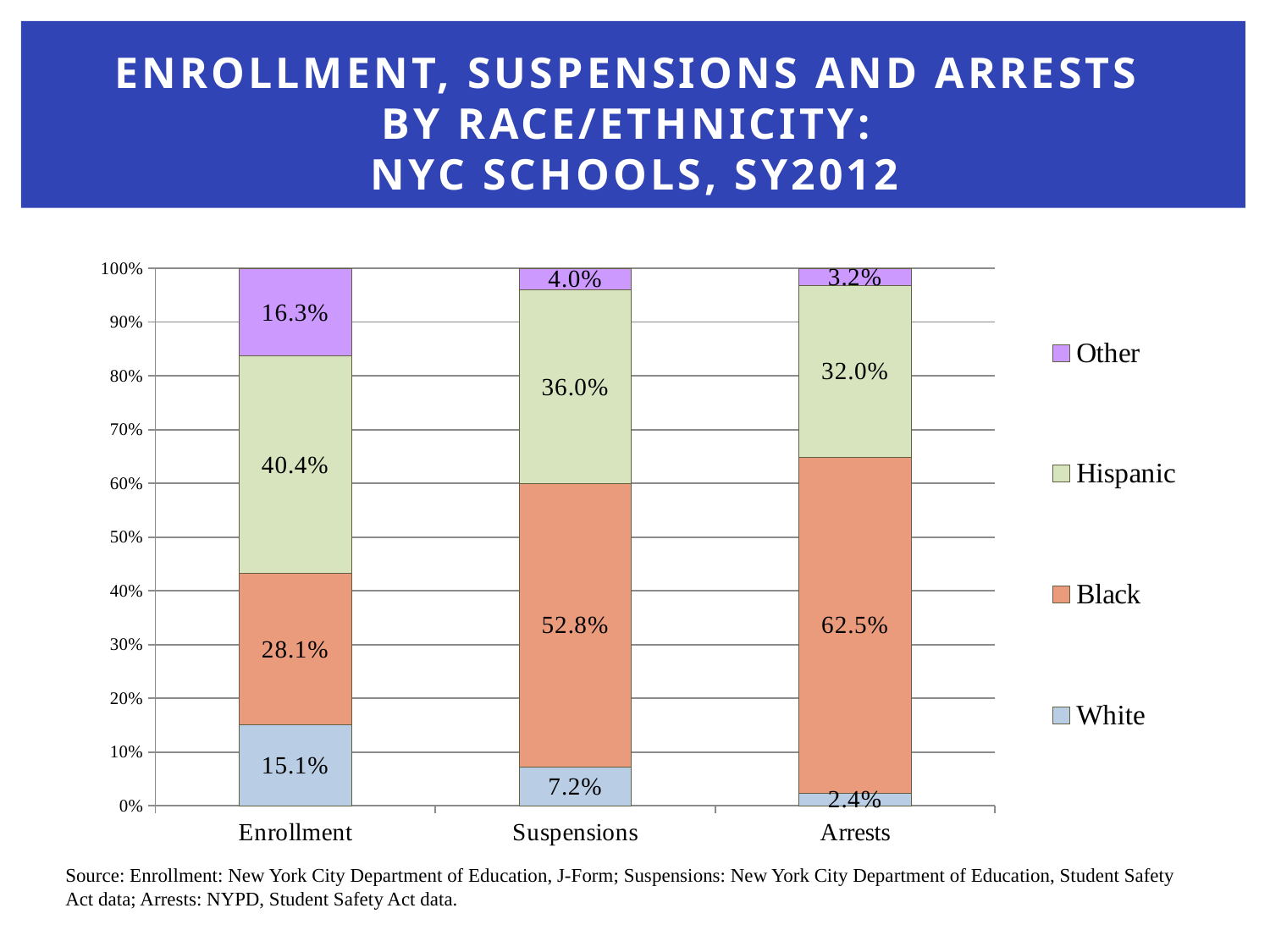
How many categories are shown on the x axis? 3 Which category has the lowest White share? Arrests What is the Hispanic share of Suspensions? 36.0% Which category has the highest Black share? Arrests What is the White share of Enrollment? 15.1% What is the Other share of Arrests? 3.2% Does the Black share rise or fall from Enrollment to Suspensions to Arrests? Rise What is the difference between the Black share of Arrests and the Black share of Enrollment? 34.4% How many series does the legend list? 4 What is the Black share of Arrests? 62.5% What kind of chart is shown on the slide? Stacked bar chart Which is larger, the Hispanic share of Enrollment or the Hispanic share of Suspensions? Hispanic share of Enrollment